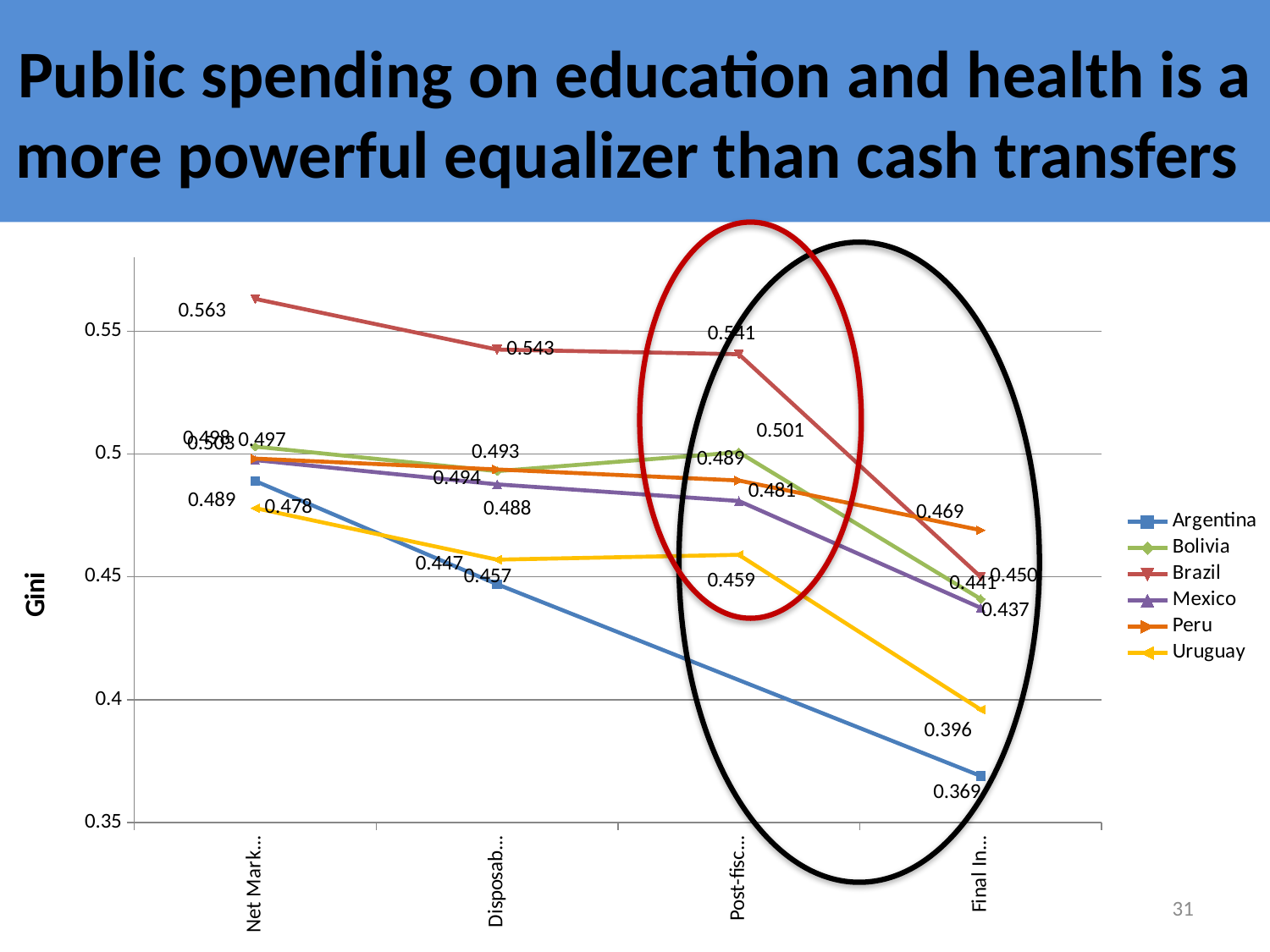
How many series does the legend list? 6 How many categories are shown along the x axis? 4 Does the Gini value for Argentina rise or fall from the first category to the last? fall At the last category (Final In...), which is larger: the Gini for Uruguay or for Argentina? Uruguay Which country has the lowest Gini value at the last category (Final In...)? Argentina What is the Gini value for Uruguay at the last category (Final In...)? 0.396 Which country has the highest Gini value at the last category (Final In...)? Peru What is the difference between Brazil's Gini at the first category (0.563) and at the last category (0.450)? 0.113 What is the Gini value for Argentina at the last category (Final In...)? 0.369 Is the Gini value for Brazil at the Post-fisc... category greater or less than 0.5? greater What type of chart is shown on the slide? line chart What is the Gini value for Brazil at the first category (Net Mark...)? 0.563